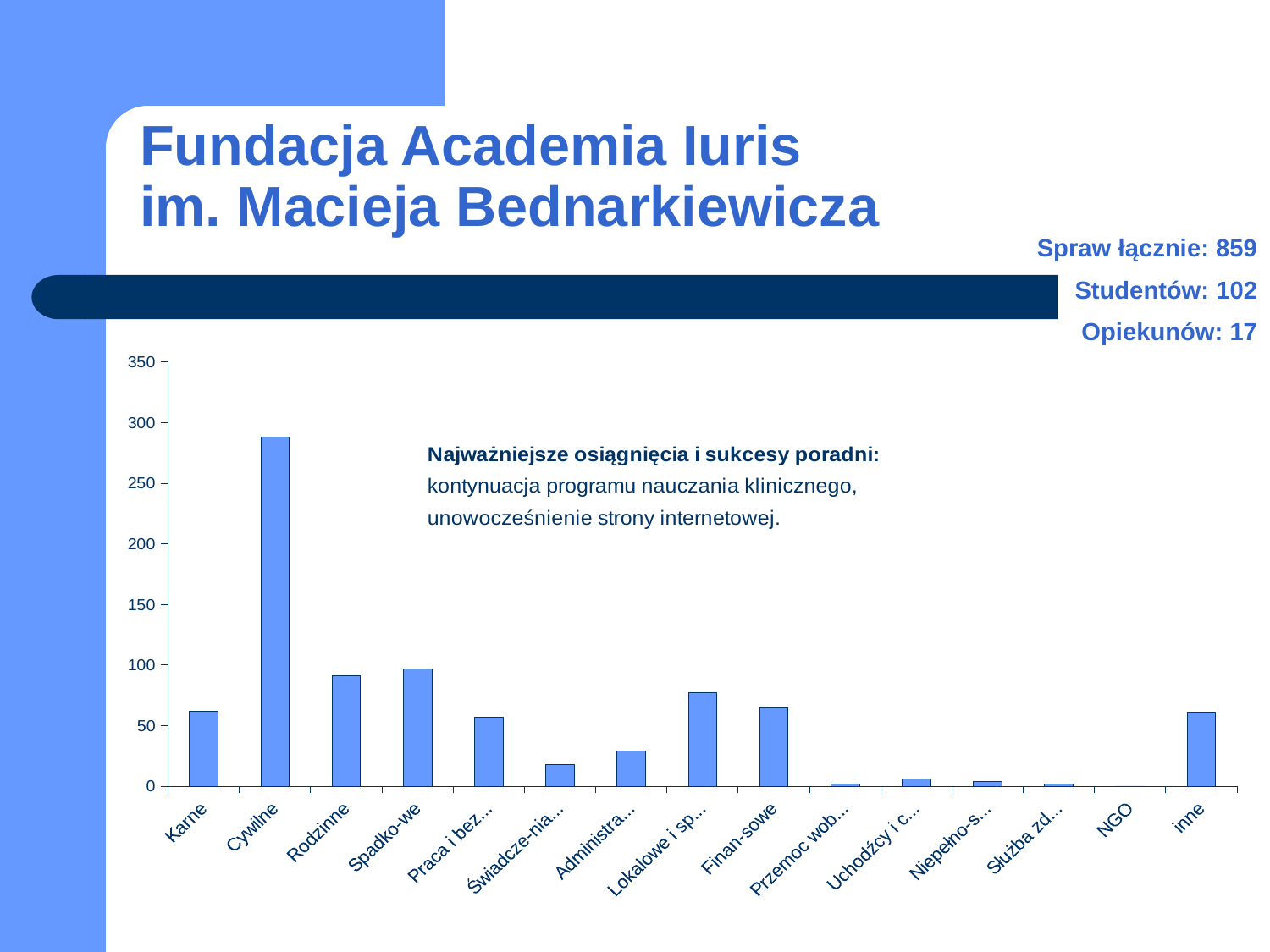
Which is larger, the value for Rodzinne or the value for Praca i bez...? Rodzinne Is the value for Rodzinne greater or less than 100? less Is the value for Cywilne greater or less than 300? less Is the value for Karne greater or less than 50? greater What is the highest tick value shown on the y axis of the chart? 350 Which category has the lowest value in the chart? NGO How many categories are shown on the x axis of the chart? 15 Which is larger, the value for Cywilne or the value for Karne? Cywilne What kind of chart is shown on the slide? bar chart Which category has the highest bar in the chart? Cywilne